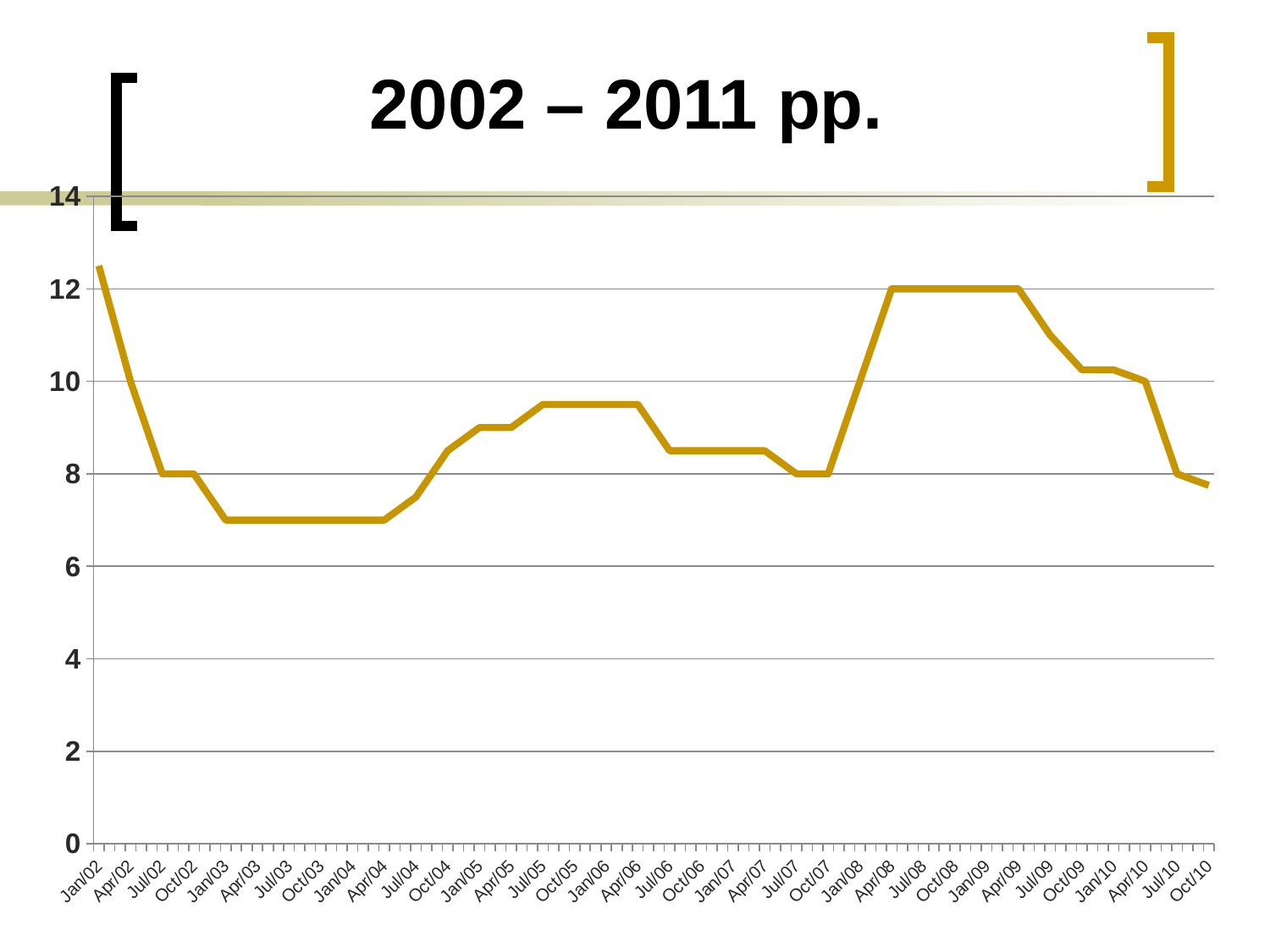
What is the value for Jul/07? 8 What is the value for Apr/08? 12 How many points are plotted along the x axis of the chart? 36 What is the title of the chart? 2002 – 2011 pp. What is the value for Jul/02? 8 Is the value for Oct/10 greater or less than 8? less Do the values rise or fall from Jan/02 to Jan/03? fall Which point has the highest value on the chart? Jan/02 What kind of chart is shown on the slide? line chart Is the value for Jan/03 greater or less than 8? less Is the value for Jul/05 greater or less than 10? less Which is larger, the value for Apr/08 or the value for Jan/03? Apr/08